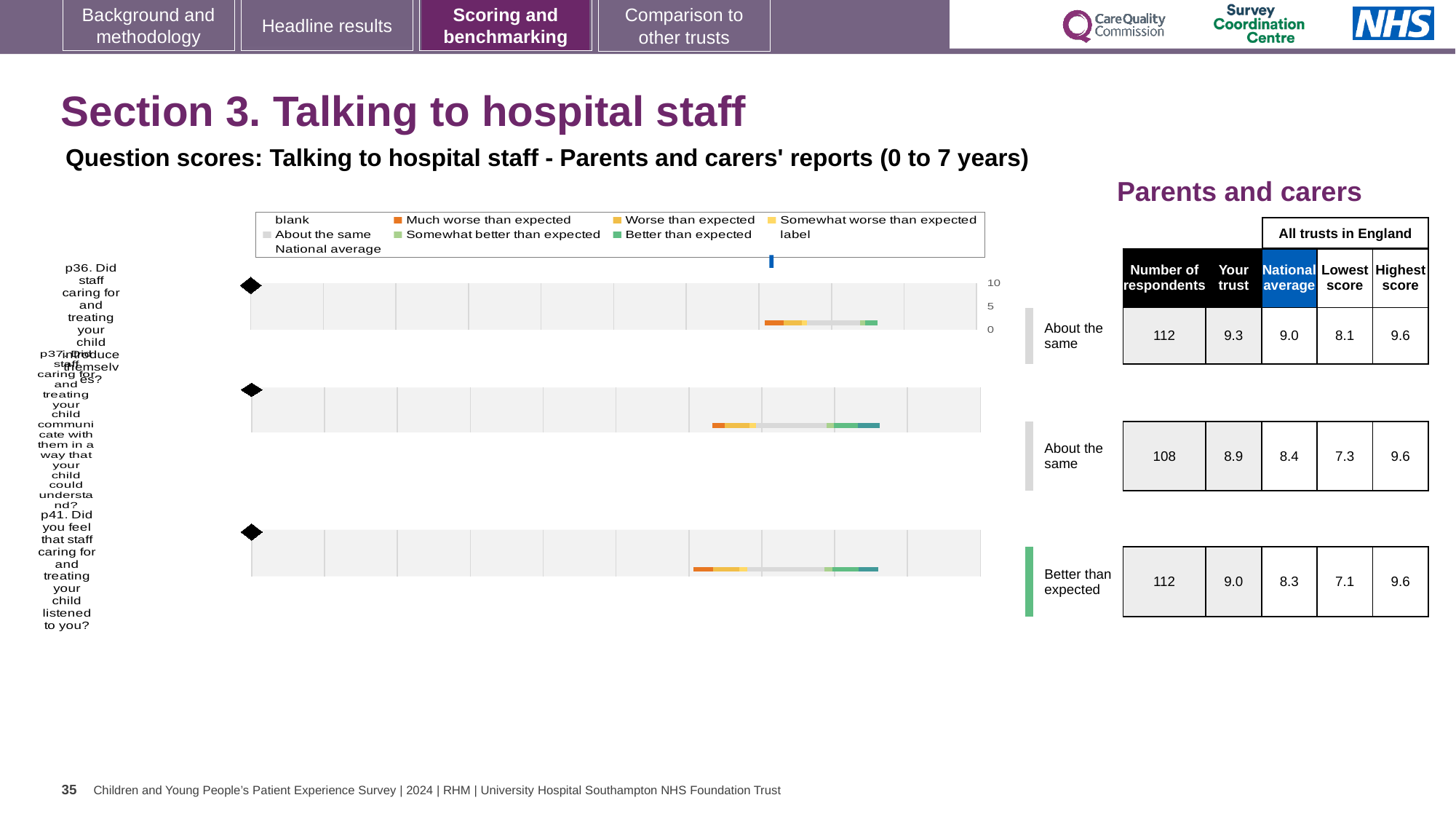
What benchmark category is shown for p41 (staff listened to you)? Better than expected For p36, what is the difference between the Highest score and the Lowest score across all trusts in England? 1.5 How many question charts (p36, p37, p41) are shown on the slide? 3 In the table beside the charts, what is the National average for p37 (communicate in a way your child could understand)? 8.4 What is the highest tick value shown on the axis of the top (p36) chart? 10 Which of the three questions has the highest 'Your trust' score? p36 In the table beside the charts, how many respondents answered p37? 108 In the table beside the charts, what is the 'Your trust' score for p36 (Did staff introduce themselves)? 9.3 In the chart legend, which category is shown in orange? Much worse than expected For p41 (staff listened to you), which is larger: the 'Your trust' score or the National average? Your trust In the table beside the charts, what is the Lowest score for p41? 7.1 What kind of chart is used to show the p36 question score? bar chart